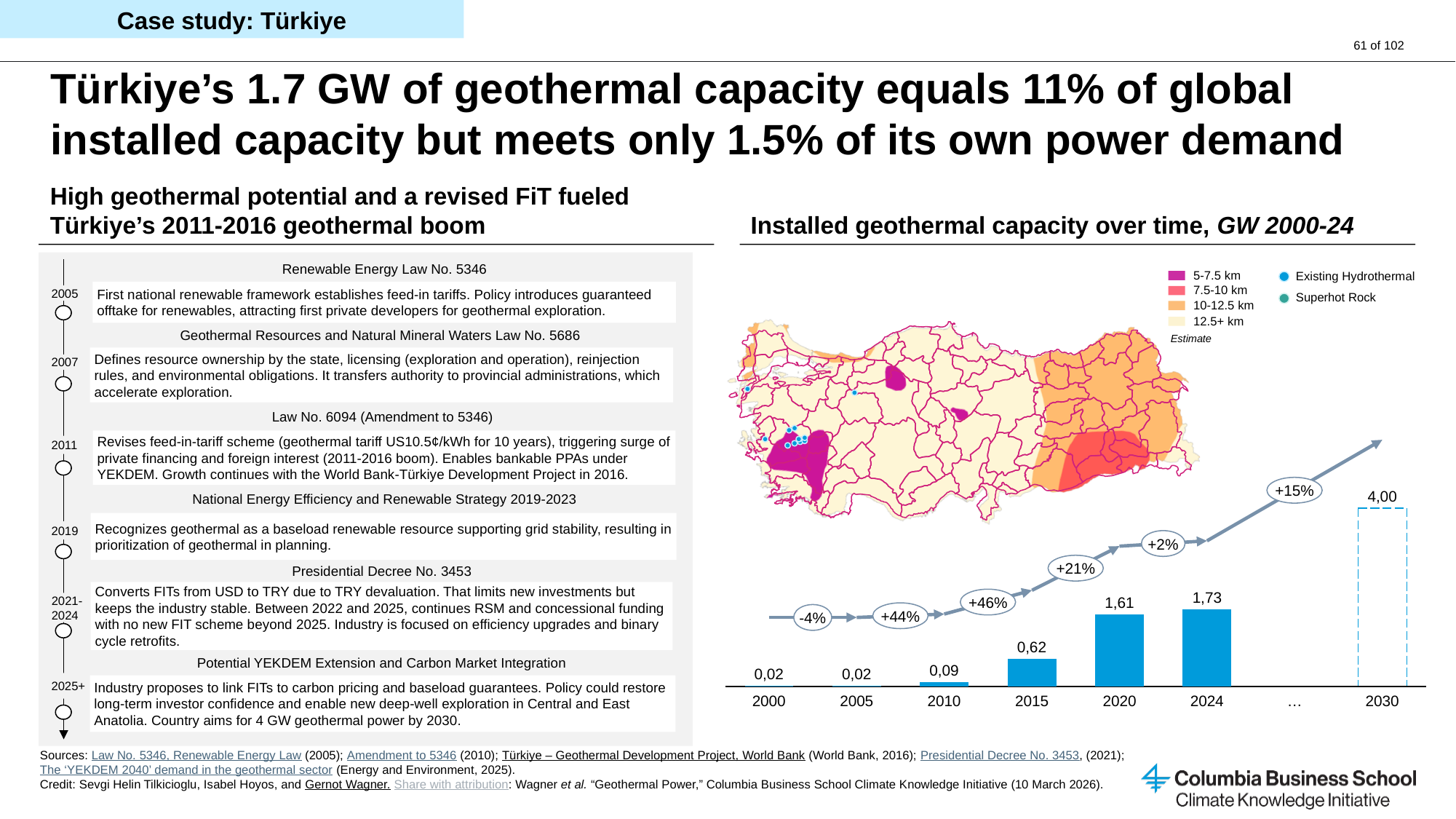
In the 'Installed geothermal capacity over time' chart, what is the installed capacity shown for 2024? 1,73 In the 'Installed geothermal capacity over time' chart, what is the installed capacity shown for 2015? 0,62 In the 'Installed geothermal capacity over time' chart, what is the difference between the 2024 and 2020 values? 0,12 In the 'Installed geothermal capacity over time' chart, what growth percentage is shown between 2020 and 2024? +2% In the 'Installed geothermal capacity over time' chart, what capacity value is shown for 2030? 4,00 In the 'Installed geothermal capacity over time' chart, which year has the highest value shown? 2030 In the 'Installed geothermal capacity over time' chart, what is the lowest capacity value shown? 0,02 In the 'Installed geothermal capacity over time' chart, do the values rise or fall from 2005 to 2024? Rise In the 'Installed geothermal capacity over time' chart, what is the value shown for 2010? 0,09 What kind of chart is 'Installed geothermal capacity over time'? Bar chart In the 'Installed geothermal capacity over time' chart, what is the difference between the 2030 value and the 2024 value? 2,27 In the 'Installed geothermal capacity over time' chart, which is larger, the value for 2015 or the value for 2020? 2020